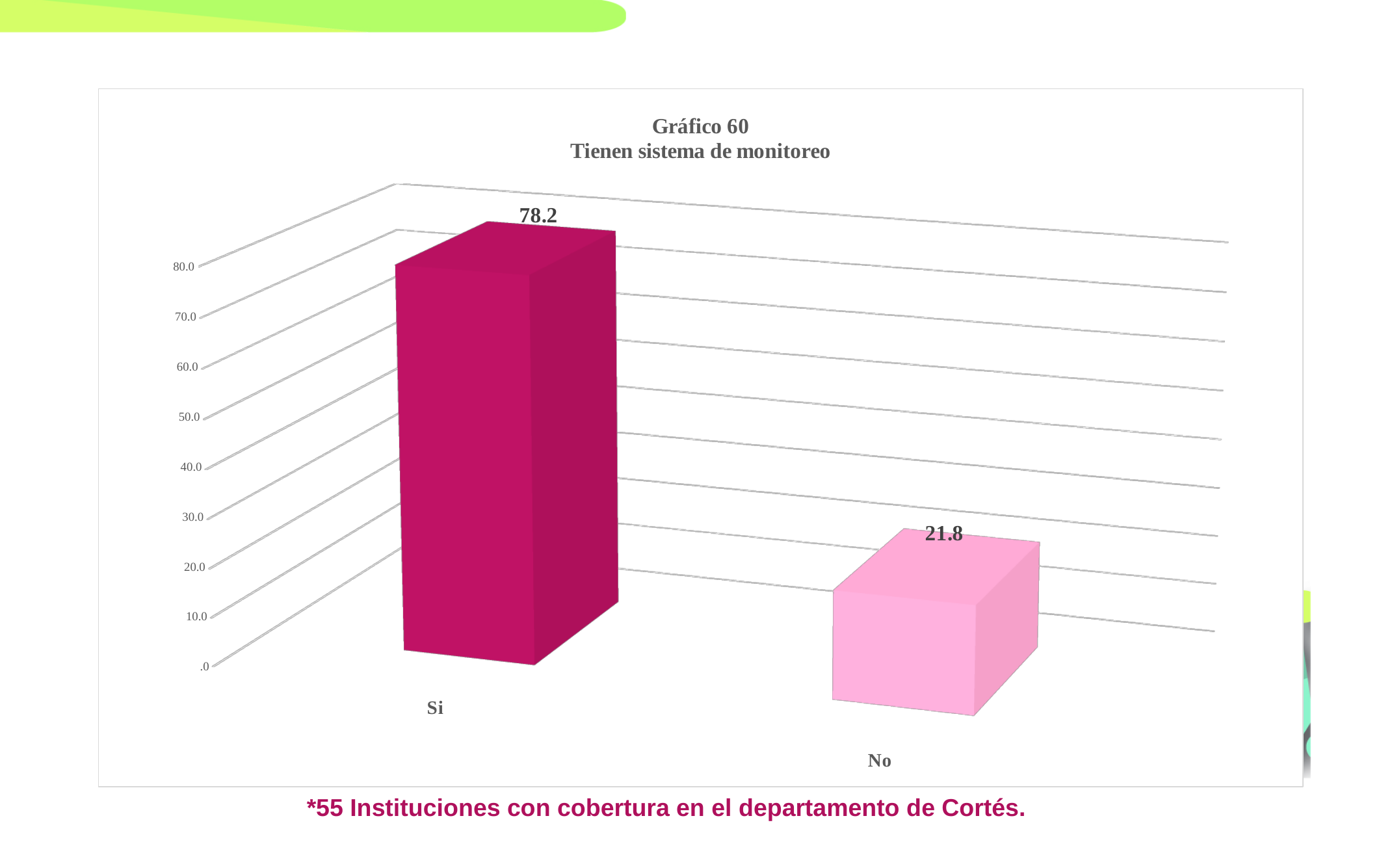
What is the total of the values for "Si" and "No"? 100.0 What is the title of the chart? Gráfico 60 Tienen sistema de monitoreo Is the value for "No" greater or less than 30.0? less What is the value for "Si"? 78.2 How many categories are shown on the chart? 2 Which category has the highest value? Si What is the value for "No"? 21.8 Which is larger, the value for "Si" or the value for "No"? Si Which category has the lowest value? No What kind of chart is shown on the slide? bar chart Is the value for "Si" greater or less than 70.0? greater What is the difference between the values for "Si" and "No"? 56.4